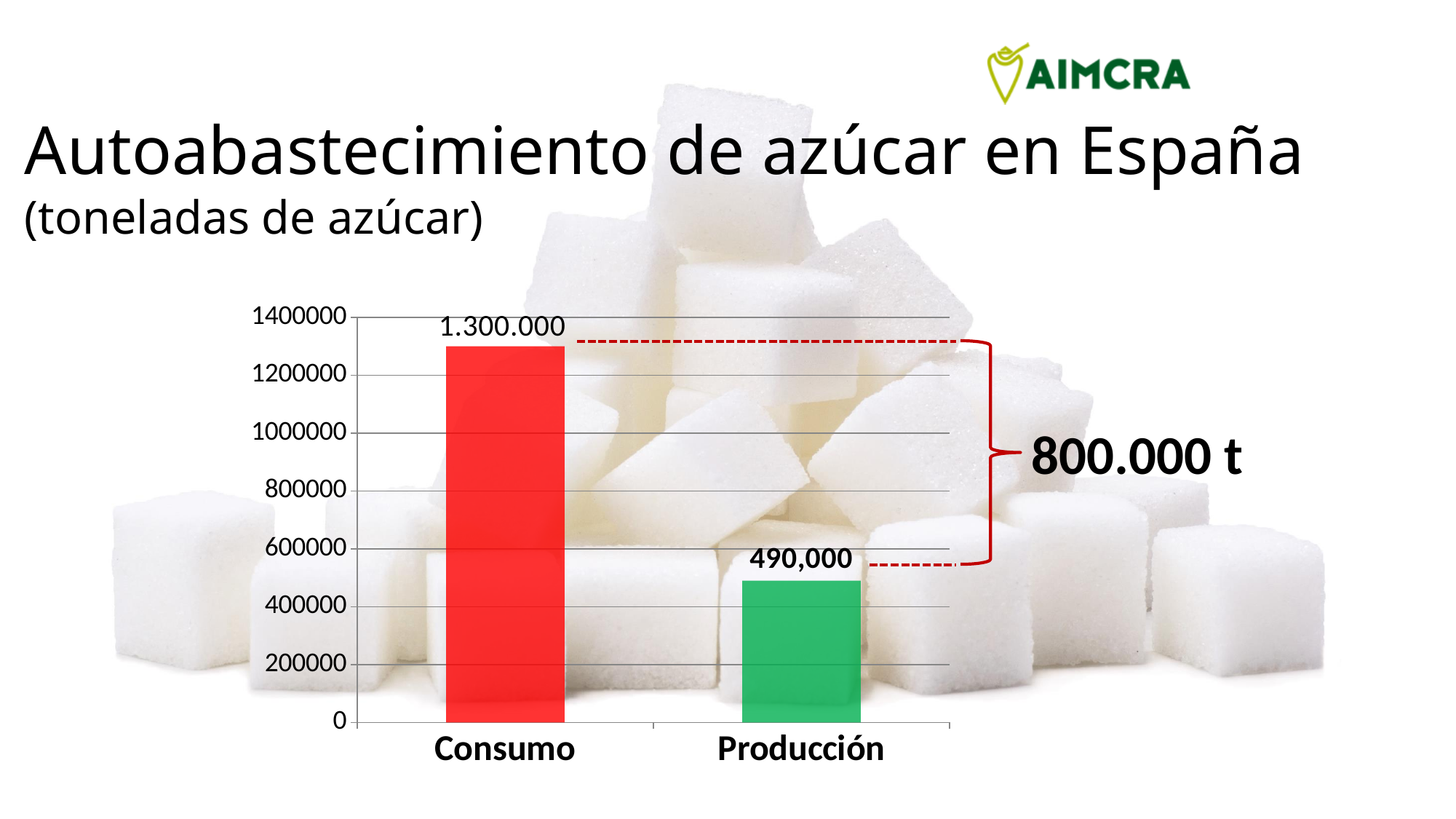
What kind of chart is shown on the slide? bar chart What colour is the Producción bar? green What is the value for Consumo? 1.300.000 How many categories are shown on the x axis? 2 What is the value for Producción? 490,000 What is the title of the slide? Autoabastecimiento de azúcar en España Which category has the highest value? Consumo Which category has the lowest value? Producción Is the value for Producción greater or less than 600000? less Is the value for Consumo greater or less than 1200000? greater Which is larger, Consumo or Producción? Consumo